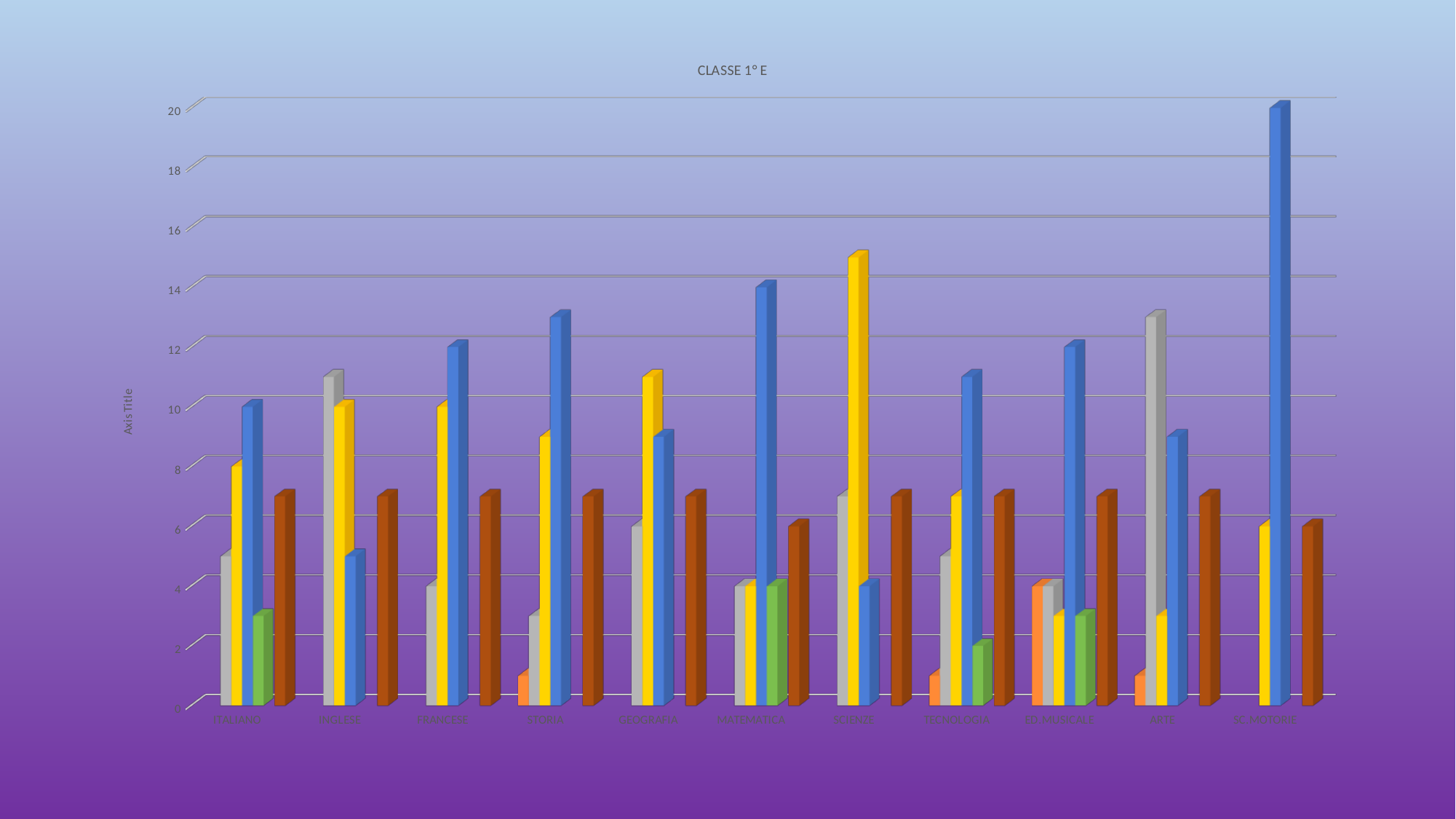
Which category contains the tallest bar in the chart? SC.MOTORIE What kind of chart is shown on the slide? bar chart Is the tallest bar for SCIENZE greater or less than 14? greater Is the tallest bar for ARTE greater or less than 14? less Is the tallest bar for ITALIANO greater or less than 12? less How many categories are shown along the x axis of the chart? 11 What is the title of the chart? CLASSE 1° E What is the highest value labelled on the vertical axis of the chart? 20